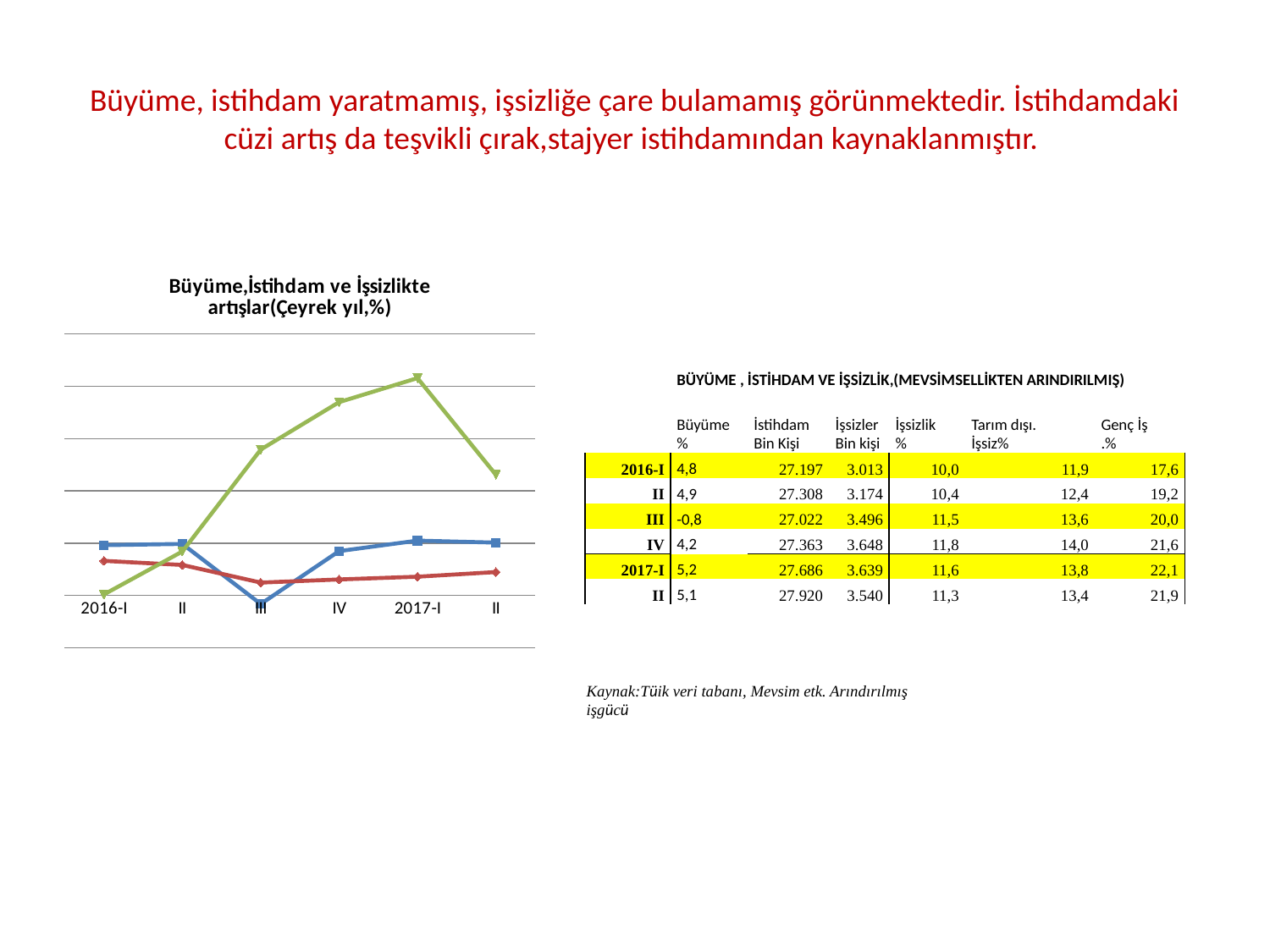
What is the first category label on the x axis of the chart? 2016-I Does the green line rise or fall between 2017-I and 2017-II? fall At which quarter is the green line at its lowest point? 2016-I Which line reaches the highest point on the chart: the blue, red or green line? green How many lines are plotted on the chart? 3 How many quarters are plotted along the x axis of the chart? 6 Does the green line rise or fall from 2016-I to 2017-I? rise What kind of chart is shown on the slide? line chart What is the title of the chart on the slide? Büyüme,İstihdam ve İşsizlikte artışlar(Çeyrek yıl,%) Which is larger for the green line: the value at 2017-I or the value at 2016-I? 2017-I At which quarter does the blue line reach its lowest point? III At which quarter does the green line reach its highest point? 2017-I